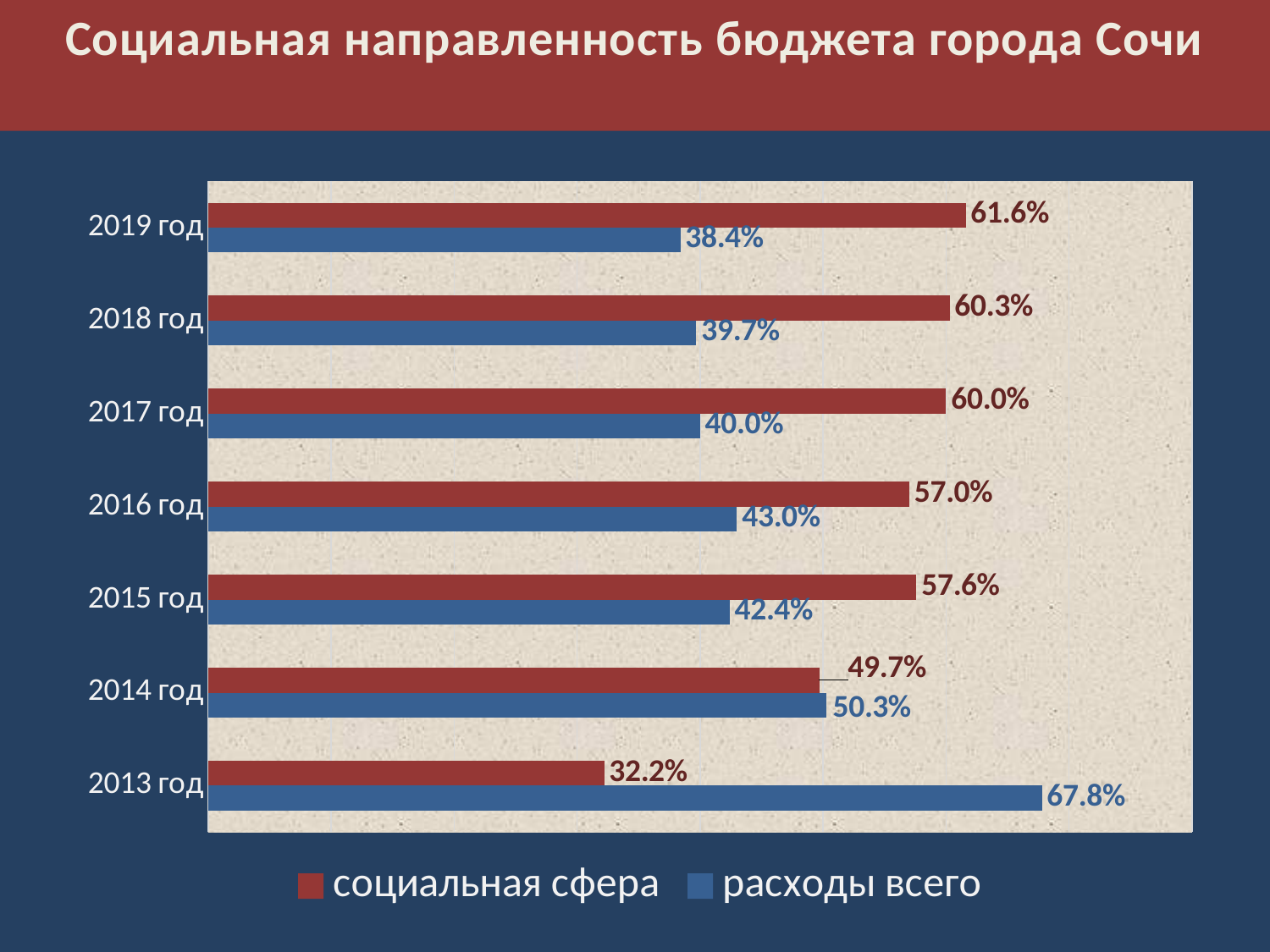
What is the value for социальная сфера in 2019 год? 61.6% What kind of chart is shown on the slide? bar chart What is the value for социальная сфера in 2014 год? 49.7% What colour are the bars for социальная сфера? red What is the value for расходы всего in 2013 год? 67.8% Which is larger in 2014 год: социальная сфера or расходы всего? расходы всего Which year has the highest value for социальная сфера? 2019 год Which year has the lowest value for расходы всего? 2019 год What is the difference between социальная сфера and расходы всего in 2018 год? 20.6% How many series does the legend list? 2 How many years are shown on the chart? 7 What is the value for расходы всего in 2016 год? 43.0%